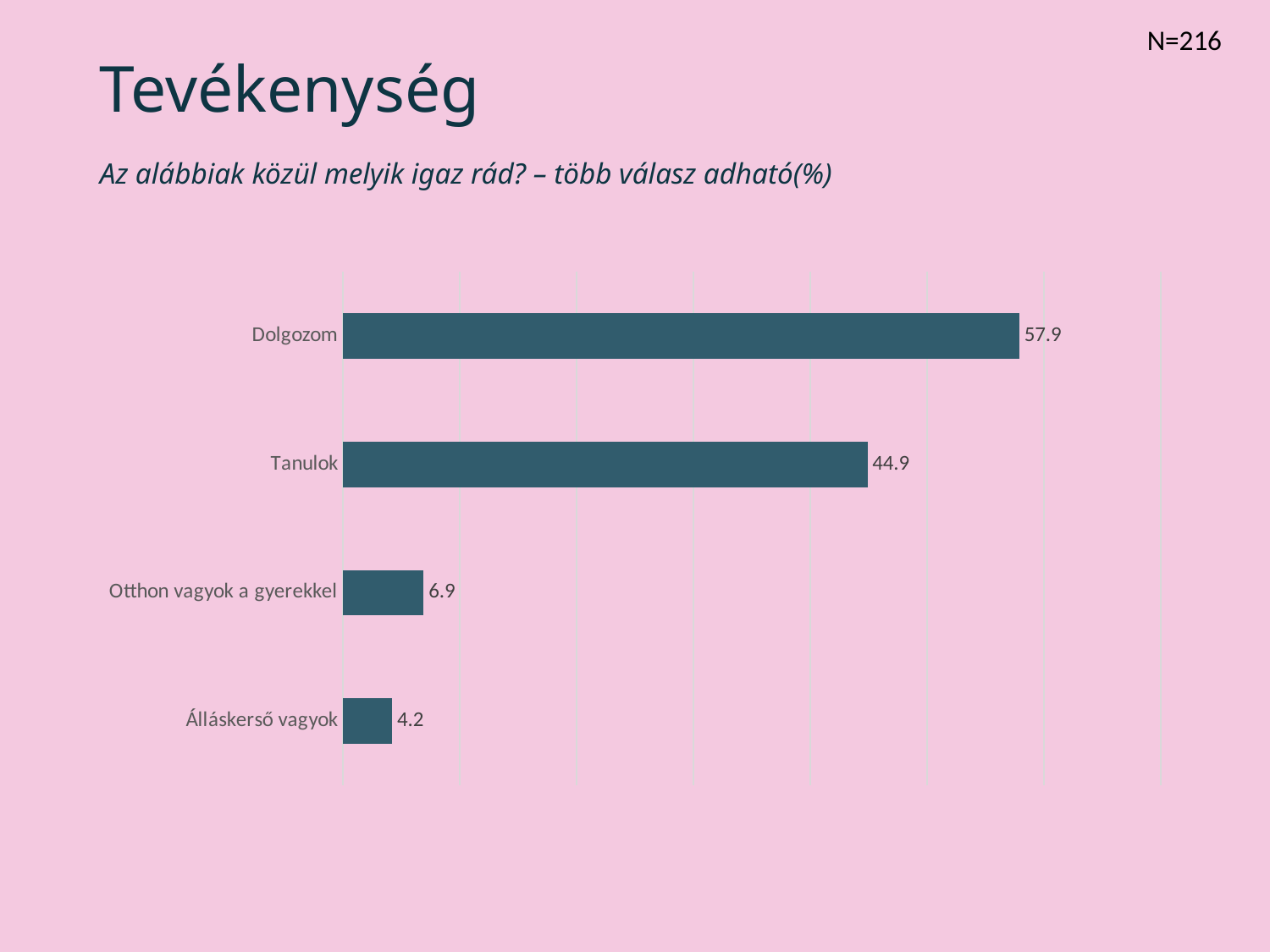
Which category has the lowest value? Álláskerső vagyok What is the value for Tanulok? 44.9 What is the difference between the values for Otthon vagyok a gyerekkel and Álláskerső vagyok? 2.7 What is the difference between the values for Dolgozom and Tanulok? 13.0 What kind of chart is shown on the slide? bar chart Which category has the highest value? Dolgozom Which is larger, the value for Tanulok or the value for Otthon vagyok a gyerekkel? Tanulok What is the value for Otthon vagyok a gyerekkel? 6.9 What is the value for Álláskerső vagyok? 4.2 What is the title of the slide? Tevékenység How many categories are shown in the chart? 4 What is the value for Dolgozom? 57.9